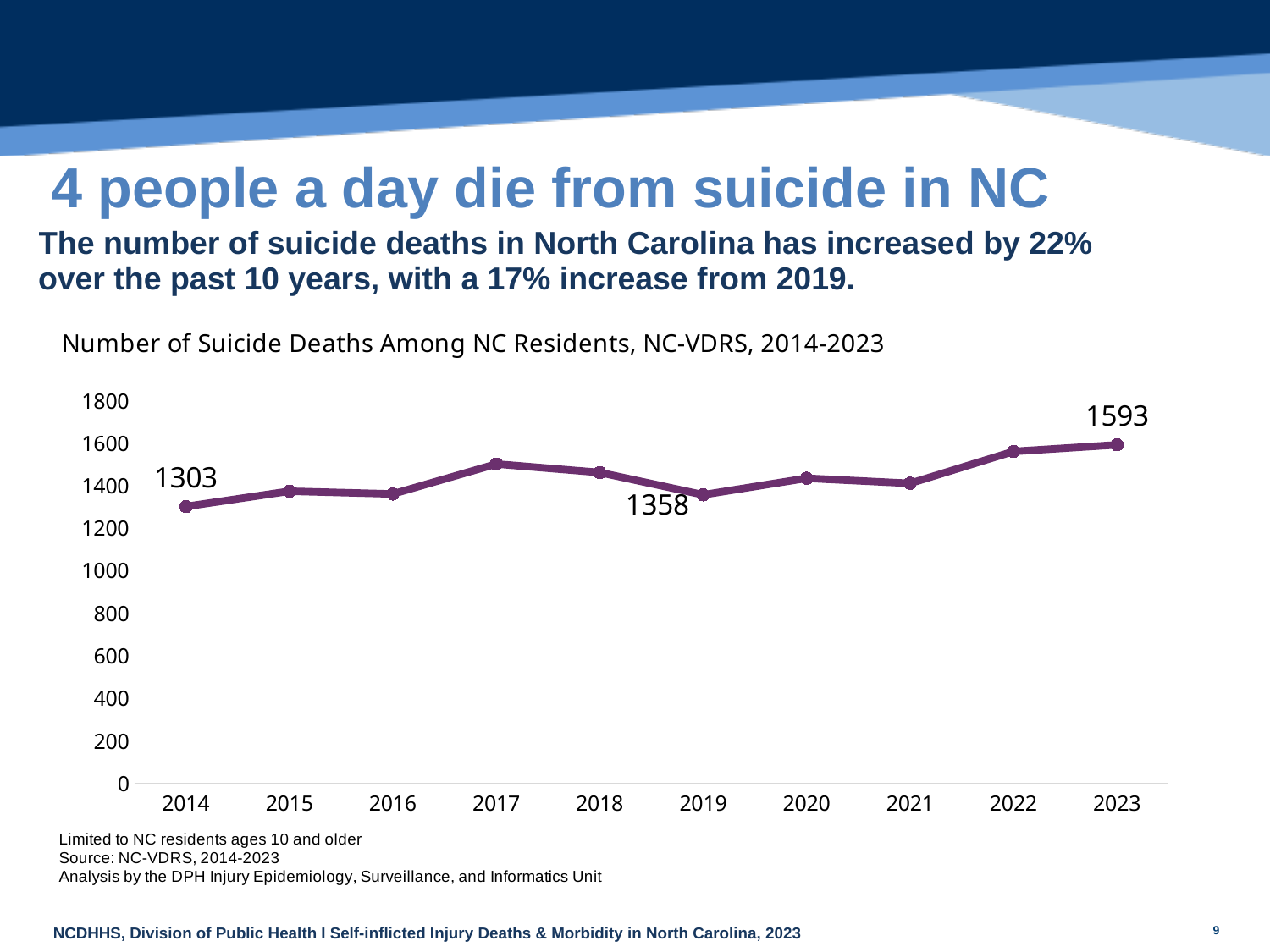
What kind of chart is shown on the slide? Line chart Which year has more suicide deaths, 2019 or 2023? 2023 What is the difference between the number of suicide deaths in 2023 and in 2019? 235 How many years are plotted on the chart? 10 Is the value for 2017 greater or less than 1400? greater Which year has the highest number of suicide deaths on the chart? 2023 What is the number of suicide deaths shown for 2014? 1303 What is the number of suicide deaths shown for 2019? 1358 What is the difference between the number of suicide deaths in 2023 and in 2014? 290 Is the value for 2021 greater or less than 1600? less Which year has the lowest number of suicide deaths on the chart? 2014 What is the number of suicide deaths shown for 2023? 1593